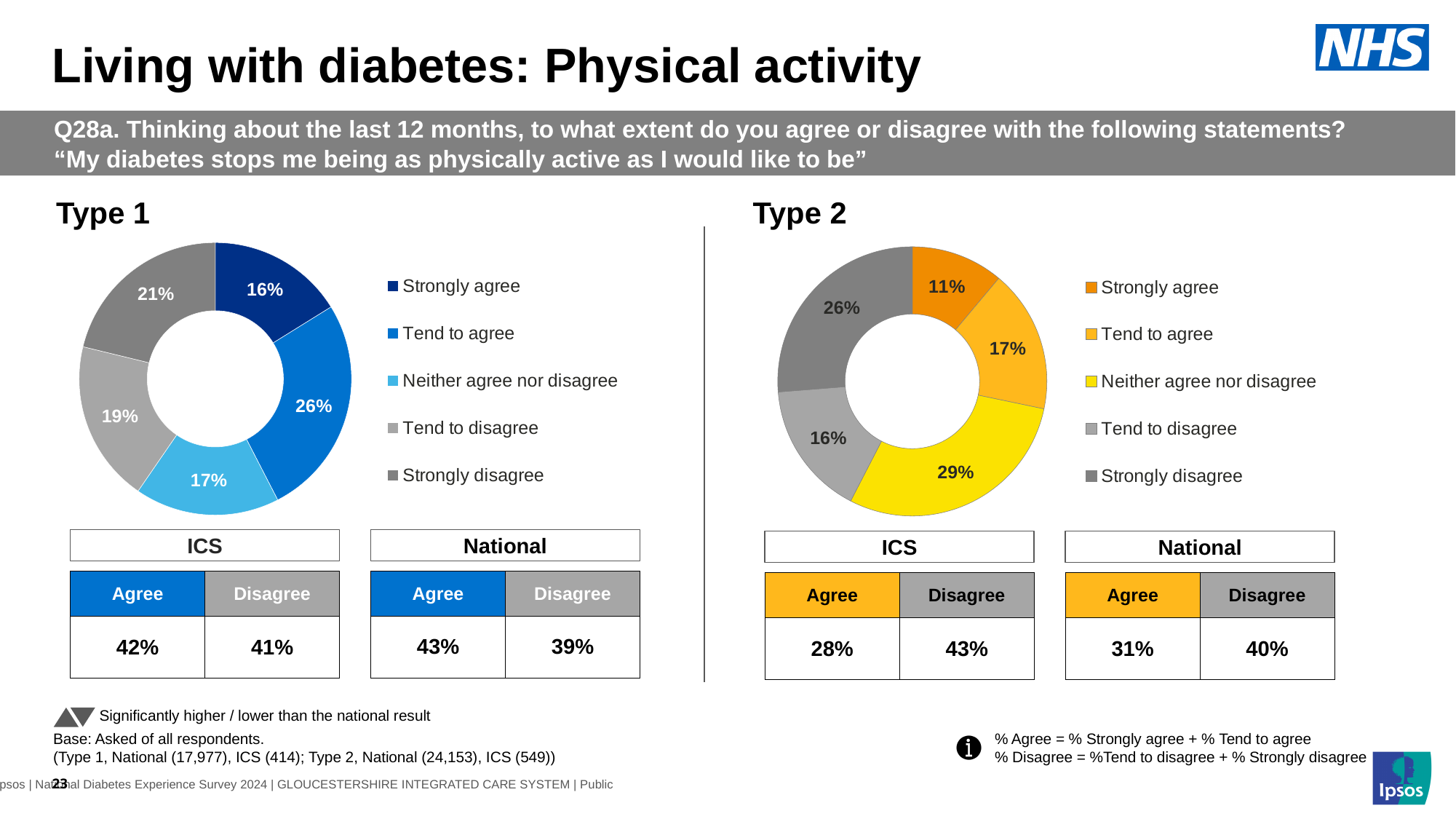
In the Type 2 chart, which is larger: 'Tend to agree' or 'Strongly disagree'? Strongly disagree What kind of chart is used for Type 1? Donut (pie) chart In the Type 1 chart, what percentage of respondents said 'Strongly agree'? 16% In the Type 1 chart, what percentage of respondents said 'Tend to disagree'? 19% In the Type 2 chart, what percentage of respondents said 'Strongly disagree'? 26% In the Type 2 chart, what colour is the 'Neither agree nor disagree' segment? Yellow In the Type 1 chart, which response category has the largest share? Tend to agree In the Type 2 chart, what percentage of respondents said 'Neither agree nor disagree'? 29% In the Type 1 chart, what is the difference between the 'Tend to agree' and 'Strongly agree' shares? 10 percentage points In the Type 2 chart, which response category has the smallest share? Strongly agree How many entries does the legend of the Type 2 chart list? 5 How many segments does the Type 1 chart have? 5